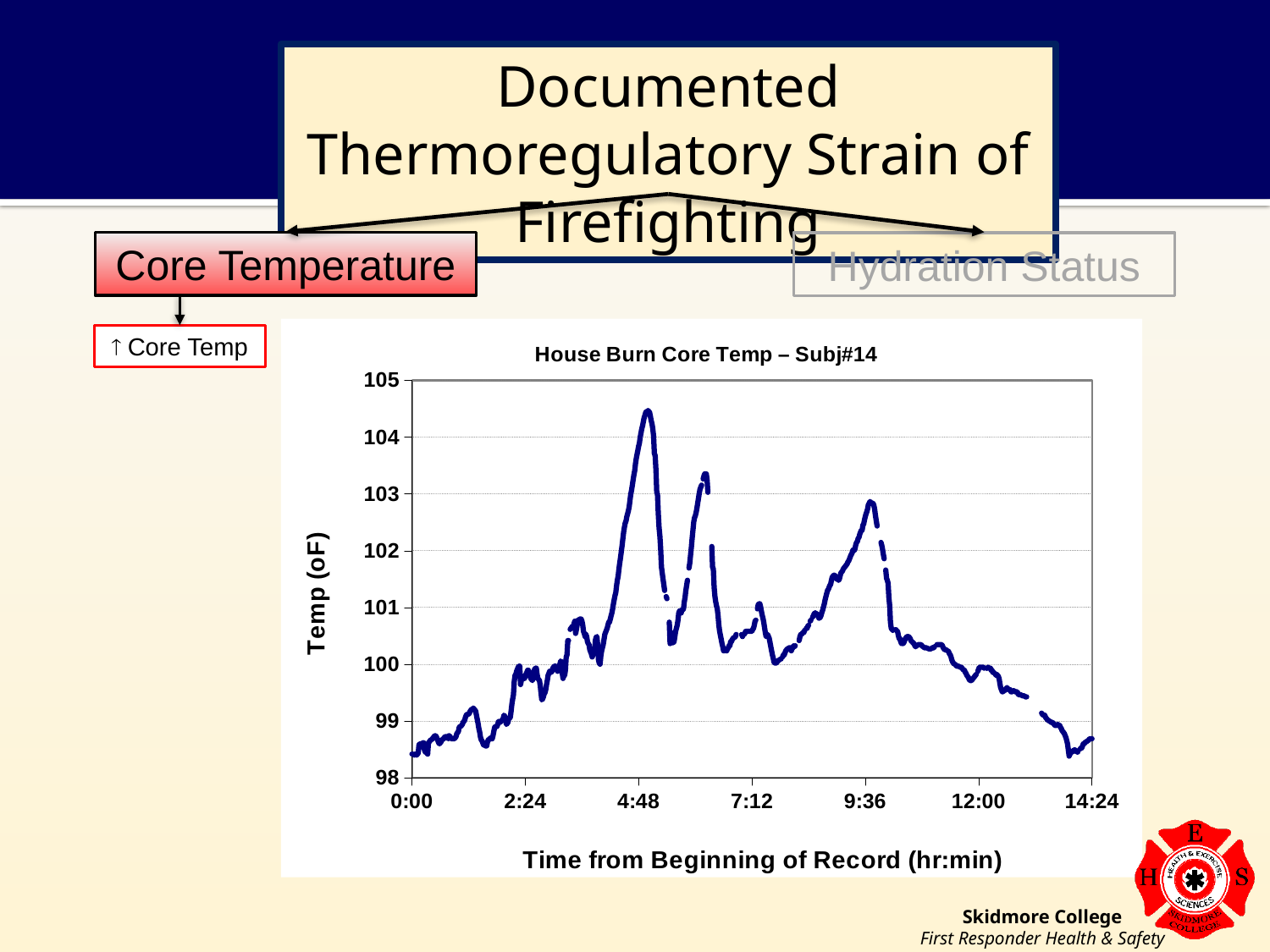
Does the core temperature rise or fall between 9:36 and 14:24? fall What is the label of the chart's y axis? Temp (oF) What is the title of the chart? House Burn Core Temp – Subj#14 Is the highest core temperature reached on the chart greater or less than 104? greater Is the core temperature at 0:00 greater or less than 99? less How many time ticks are labelled on the x axis? 7 What kind of chart is shown on the slide? line chart Is the core temperature at 14:24 greater or less than 99? less Does the core temperature rise or fall between 0:00 and 4:48? rise Near which x-axis tick does the core temperature reach its highest peak? 4:48